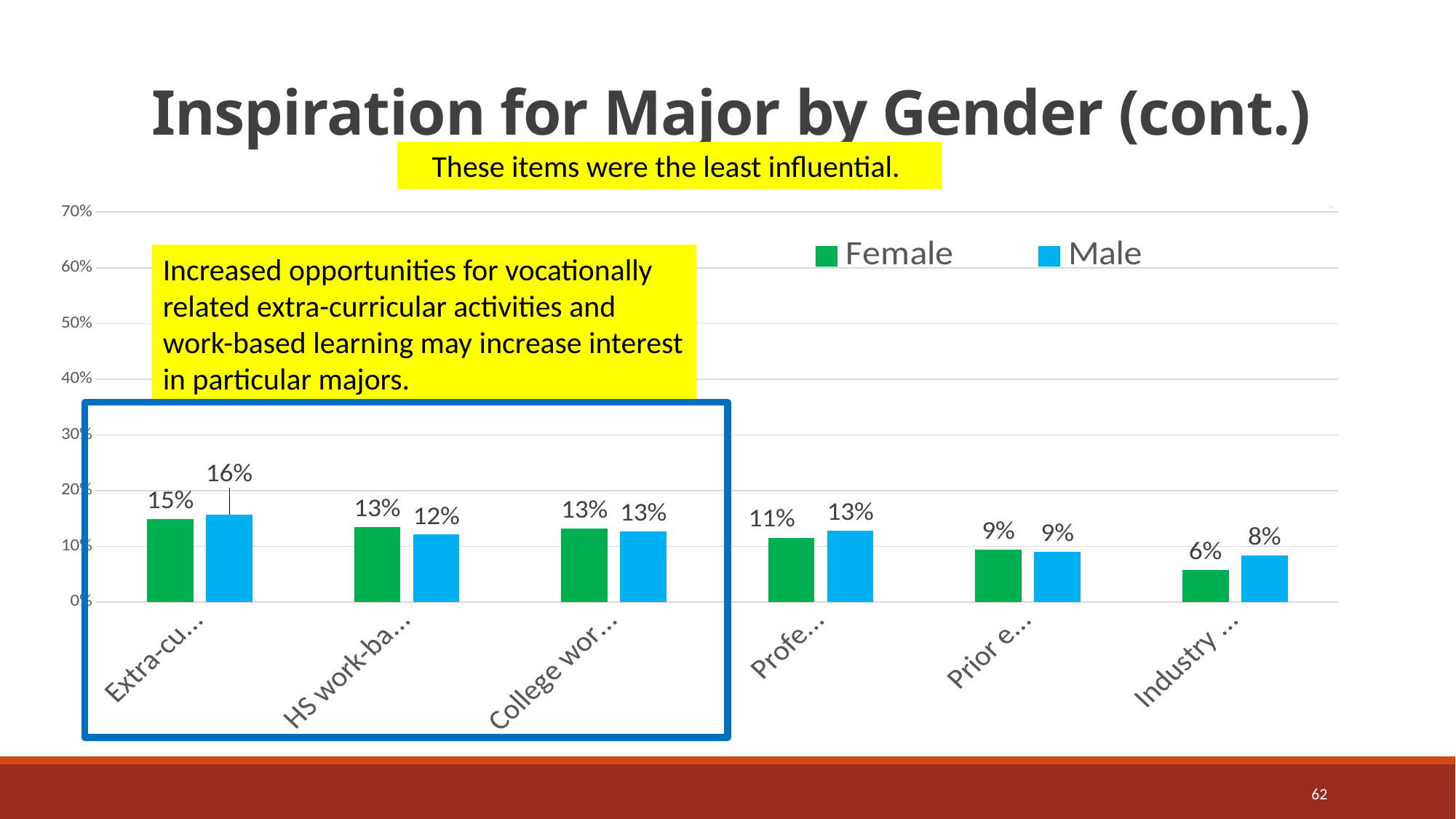
For the fourth category (Profe…), what is the difference between the Male and Female values? 2 percentage points Which category has the lowest Female value? The last category (Industry …), 6% How many categories are plotted along the x axis of the chart? 6 How many series does the chart's legend list? 2 What is the Male value for the fourth category (Profe…)? 13% For the first category (Extra-cu…), which is larger, the Female value or the Male value? Male What type of chart is shown on the slide? Bar chart What is the Male value for the last category on the right (Industry …)? 8% Which category has the highest Male value? The first category (Extra-cu…), 16% What is the difference between the Female value for the first category (Extra-cu…) and the Female value for the last category (Industry …)? 9 percentage points What is the Female value for the first category on the left (Extra-cu…)? 15% Which colour represents the Female series in the chart? Green